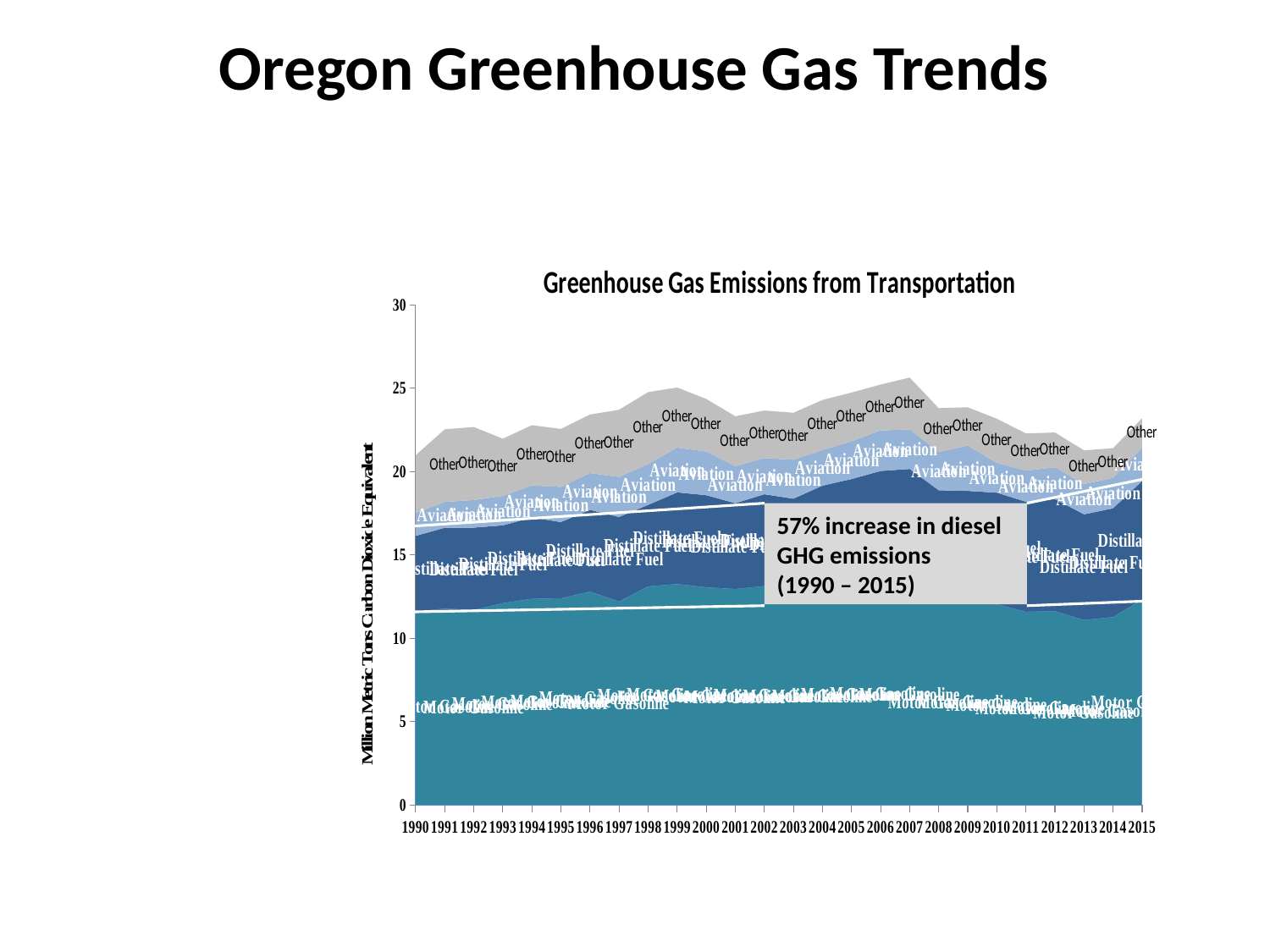
How many fuel categories (series) are stacked in the chart? 4 Is the total transportation emissions value for 1990 greater or less than 20? greater Is the Motor Gasoline value for 2015 greater or less than 10? greater Do total transportation emissions rise or fall between 2007 and 2013? fall According to the callout on the chart, by what percentage did diesel GHG emissions increase from 1990 to 2015? 57% Is the total transportation emissions value for 2013 greater or less than 25? less How many years are plotted along the x axis of the chart? 26 What kind of chart is shown on the slide? Stacked area chart What is the title of the chart? Greenhouse Gas Emissions from Transportation Which series forms the bottom (largest) layer of the stacked area chart? Motor Gasoline What is the label on the vertical axis of the chart? Million Metric Tons Carbon Dioxide Equivalent